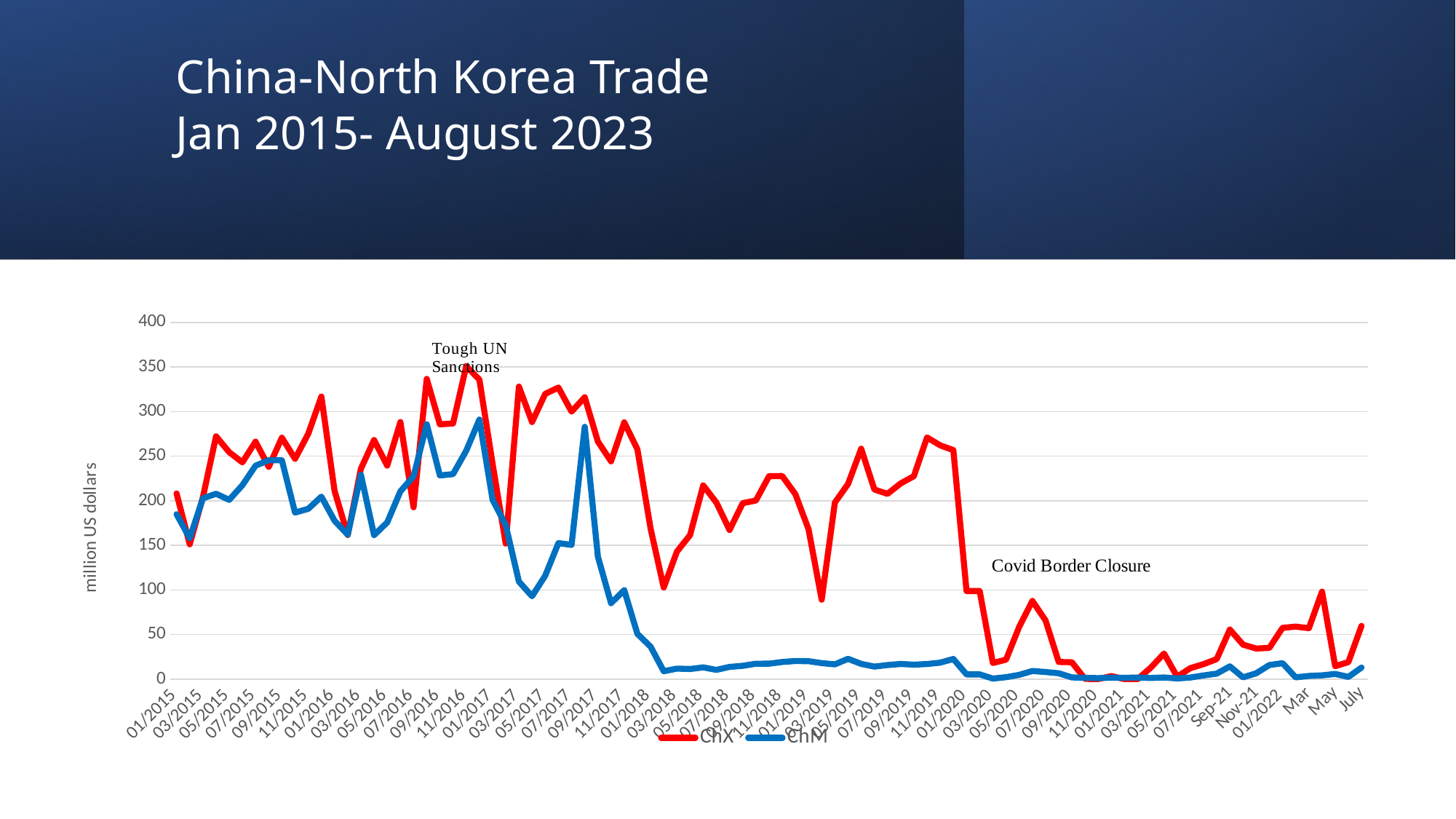
At 03/2018, which series has the larger value, ChX or ChM? ChX Is the value for ChX at 11/2019 greater or less than 200? greater Is the value for ChX at 01/2015 greater or less than 150? greater Is the value for ChM at 03/2018 greater or less than 50? less At 11/2019, which series has the larger value, ChX or ChM? ChX Does the ChM line rise or fall between 09/2017 and 03/2018? fall What are the names of the two series in the legend? ChX and ChM What is the label on the vertical axis? million US dollars What kind of chart is shown on the slide? line chart How many series does the legend list? 2